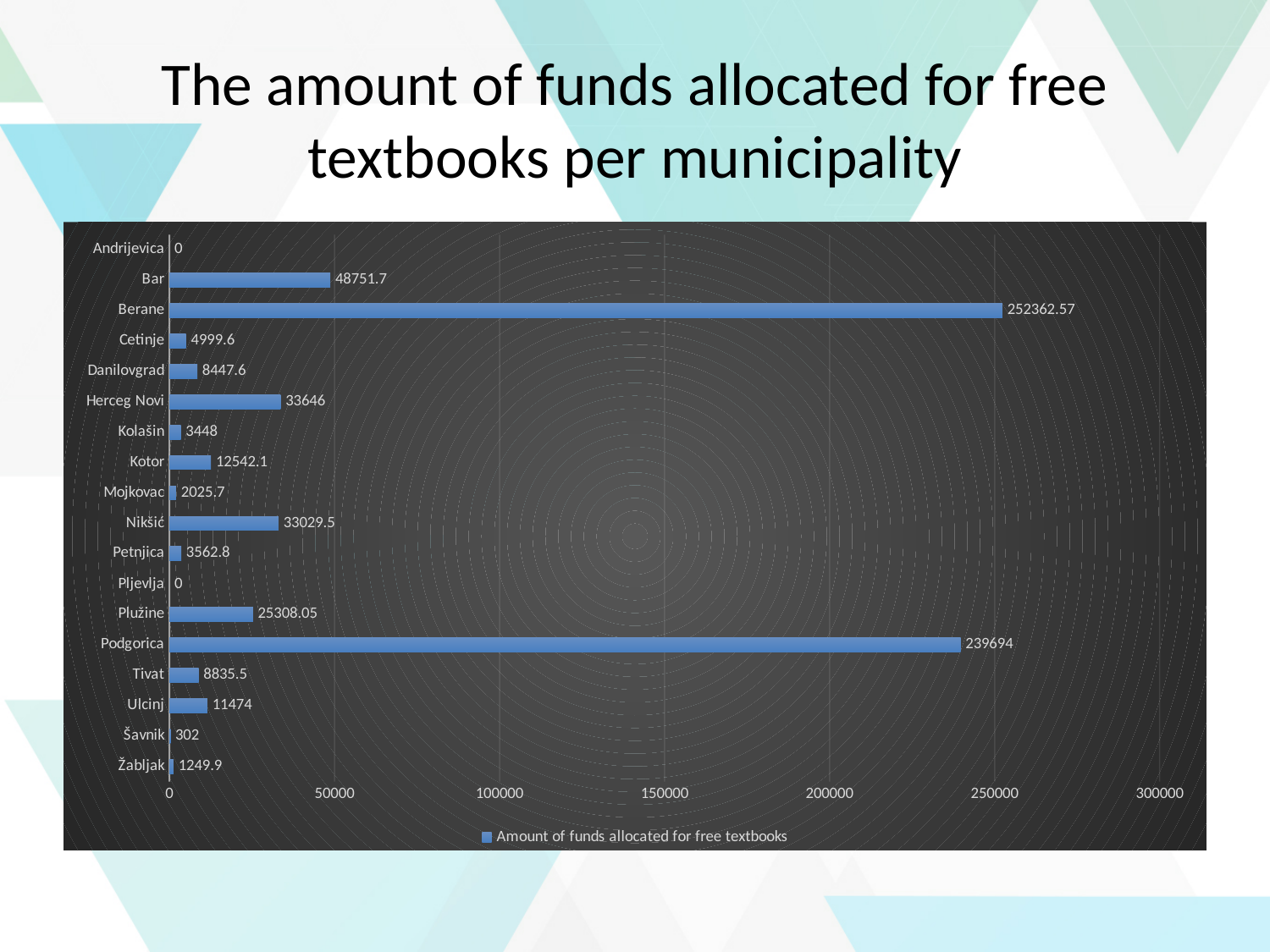
What is the value shown for Plužine? 25308.05 Which municipality has the highest amount of funds allocated for free textbooks? Berane What is the value shown for Šavnik? 302 What is the difference between the values for Bar and Herceg Novi? 15105.7 Is the value for Bar greater or less than 50000? less What is the difference between the values for Berane and Podgorica? 12668.57 What is the value shown for Podgorica? 239694 How many municipalities are shown on the chart? 18 How many series does the legend list? 1 What is the amount of funds allocated for free textbooks for Berane? 252362.57 Which has a larger value, Bar or Plužine? Bar What kind of chart is shown on the slide? Bar chart